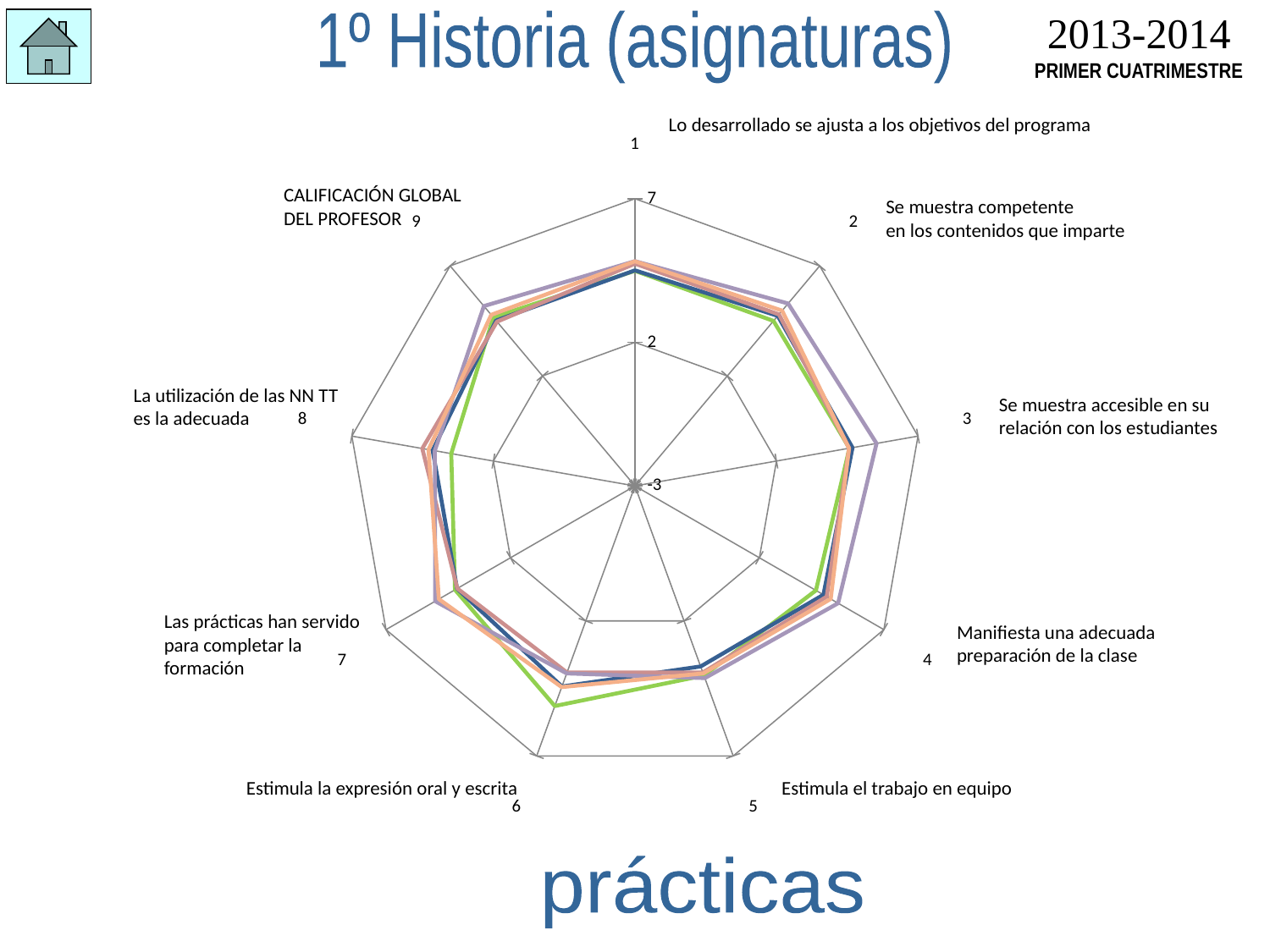
What kind of chart is shown on the slide? radar chart Which category is labelled with the number 9 on the radar chart? CALIFICACIÓN GLOBAL DEL PROFESOR Are the plotted values for 'La utilización de las NN TT es la adecuada' greater or less than 2? greater Are the plotted values for 'Estimula la expresión oral y escrita' greater or less than 2? greater Are the plotted values for 'Se muestra accesible en su relación con los estudiantes' greater or less than 2? greater What is the title of the slide containing the radar chart? 1º Historia (asignaturas) What is the highest tick value shown on the radar chart's axis? 7 How many categories (axes) does the radar chart have? 9